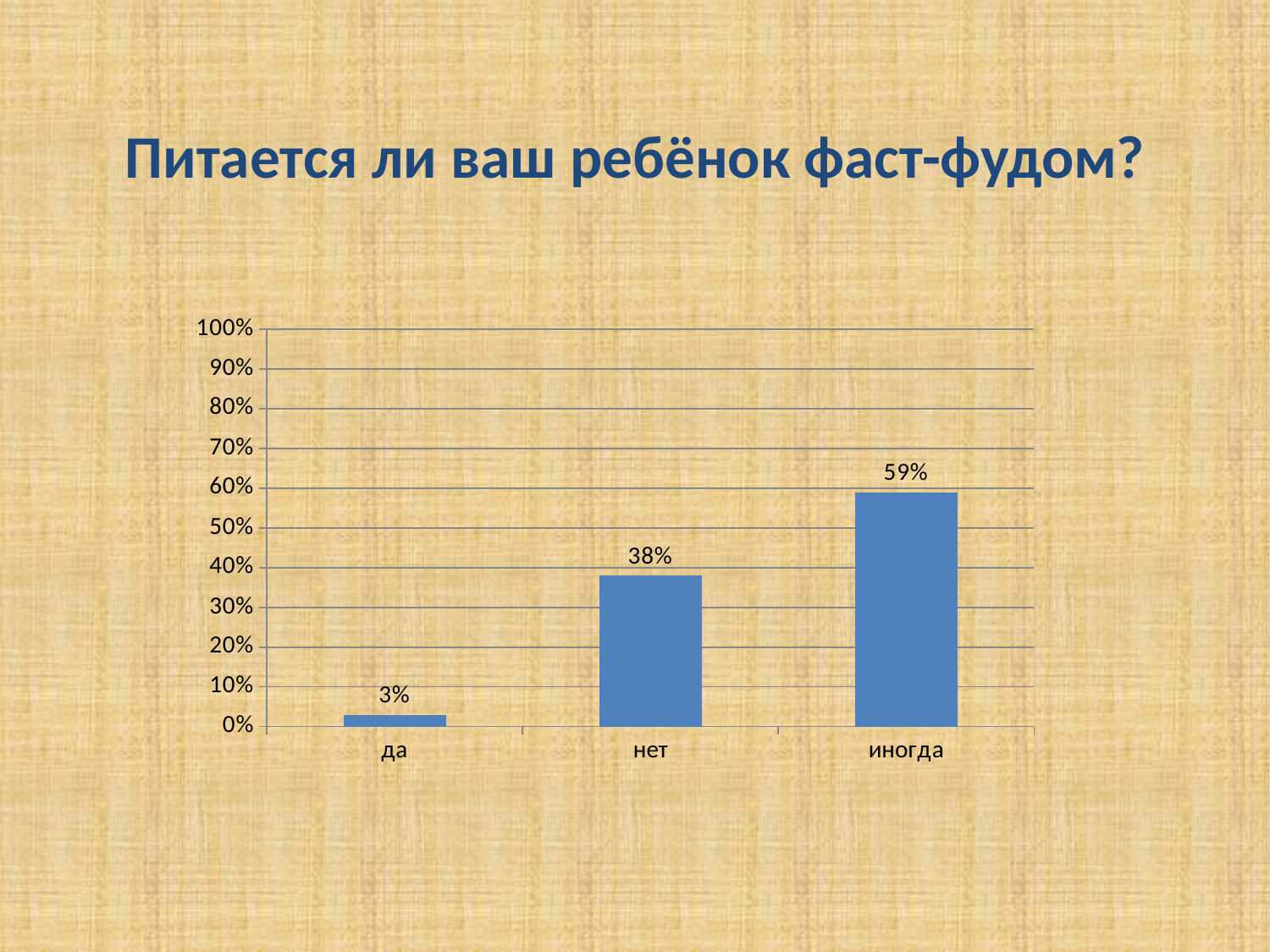
What is the title of the slide? Питается ли ваш ребёнок фаст-фудом? What is the value for "нет"? 38% How many categories are shown on the x axis? 3 Which category has the lowest value? да What is the value for "иногда"? 59% Which category has the highest value? иногда Is the value for "иногда" greater or less than 50%? greater What is the value for "да"? 3% What is the difference between the values for "нет" and "да"? 35% What kind of chart is shown on the slide? bar chart What is the difference between the values for "иногда" and "нет"? 21% Which is larger, the value for "нет" or the value for "да"? нет